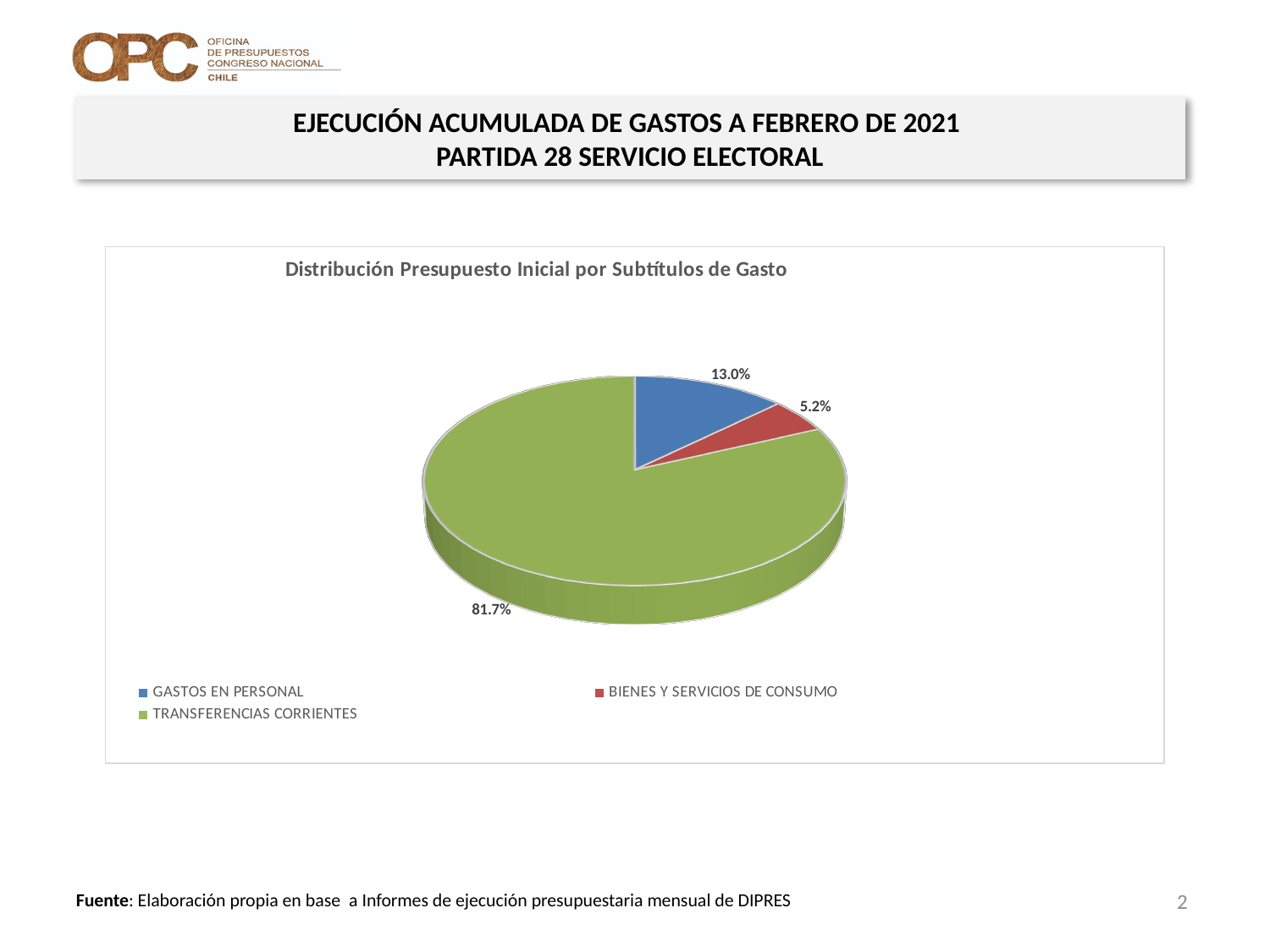
What share of the pie does GASTOS EN PERSONAL represent? 13.0% Which colour represents BIENES Y SERVICIOS DE CONSUMO in the chart? Red What is the difference in percentage points between the shares of TRANSFERENCIAS CORRIENTES and GASTOS EN PERSONAL? 68.7 What is the difference in percentage points between the shares of GASTOS EN PERSONAL and BIENES Y SERVICIOS DE CONSUMO? 7.8 Which category has the smallest share of the pie? BIENES Y SERVICIOS DE CONSUMO What share of the pie does TRANSFERENCIAS CORRIENTES represent? 81.7% Which category has the largest share of the pie? TRANSFERENCIAS CORRIENTES Which has a larger share, GASTOS EN PERSONAL or BIENES Y SERVICIOS DE CONSUMO? GASTOS EN PERSONAL How many categories are shown in the pie chart? 3 What share of the pie does BIENES Y SERVICIOS DE CONSUMO represent? 5.2% What kind of chart is shown on the slide? Pie chart What is the title of the chart? Distribución Presupuesto Inicial por Subtítulos de Gasto